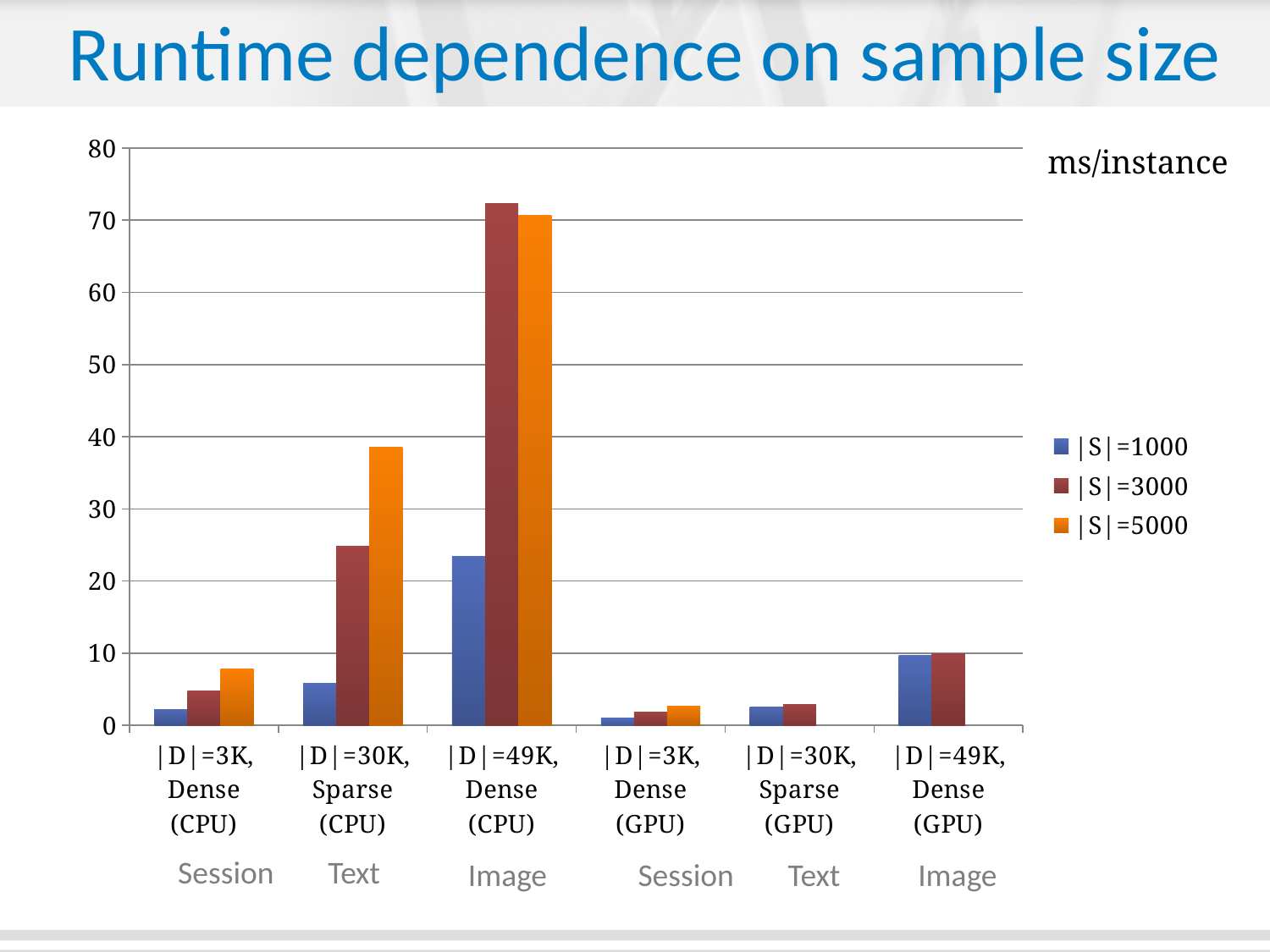
How many series does the legend list? 3 Is the |S|=5000 value for |D|=30K, Sparse (CPU) greater or less than 30? greater For the |S|=1000 series, which category has the lowest value? |D|=3K, Dense (GPU) Is the |S|=1000 value for |D|=49K, Dense (CPU) greater or less than 20? greater What unit is given for the values in the chart? ms/instance For |D|=30K, Sparse (CPU), which is larger: the |S|=3000 value or the |S|=5000 value? |S|=5000 For the |S|=1000 series, which is larger: |D|=49K, Dense (CPU) or |D|=30K, Sparse (CPU)? |D|=49K, Dense (CPU) What kind of chart is shown on the slide? bar chart For the |S|=5000 series, which category has the highest value? |D|=49K, Dense (CPU) Is the |S|=3000 value for |D|=30K, Sparse (CPU) greater or less than 20? greater How many categories are shown on the x axis? 6